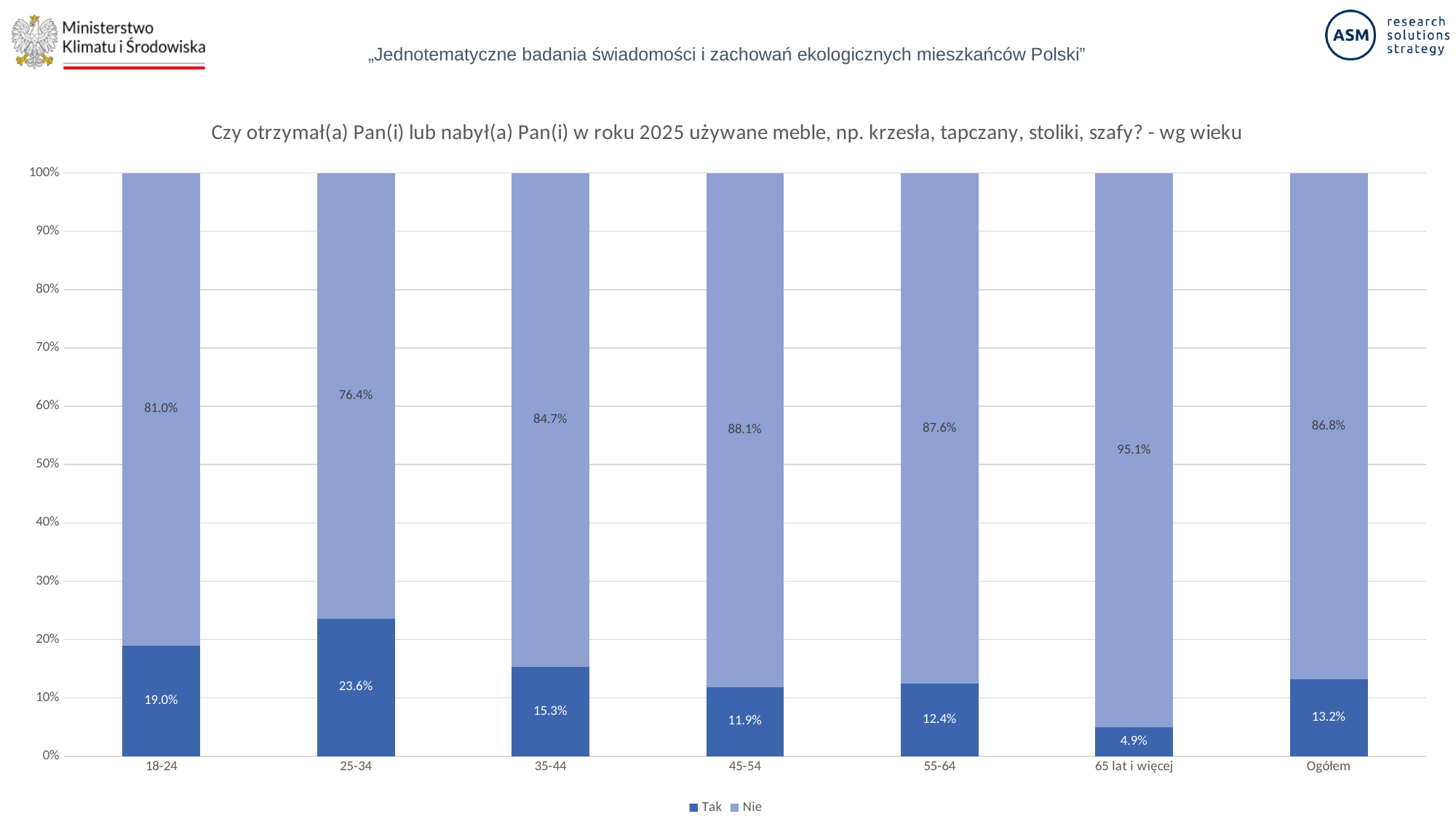
What is the total of the stacked bar for 45-54? 100% What is the 'Tak' value for the 25-34 age group? 23.6% What is the difference between the 'Tak' values for 18-24 and 45-54? 7.1% Which is larger, the 'Tak' value for 35-44 or for 55-64? 35-44 How many series does the legend list? 2 Which age group has the lowest 'Tak' value? 65 lat i więcej Is the 'Nie' value for 18-24 greater or less than 80%? greater What is the 'Nie' value for the 65 lat i więcej age group? 95.1% What kind of chart is shown on the slide? stacked bar chart What is the 'Tak' value for Ogółem? 13.2% Which age group has the highest 'Tak' value? 25-34 How many categories are shown on the x axis? 7